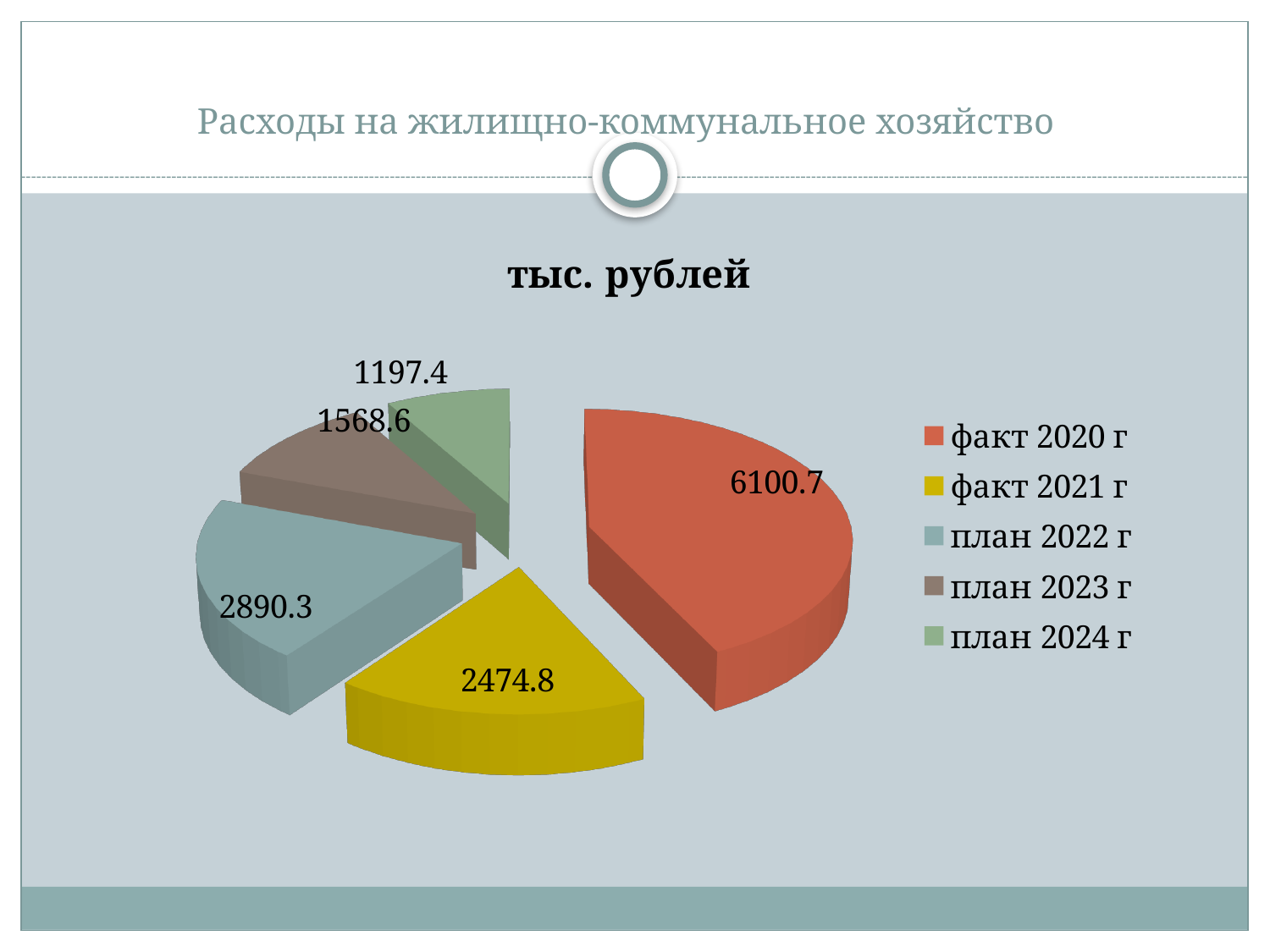
What is the difference between факт 2020 г and факт 2021 г? 3625.9 Which is larger, план 2022 г or факт 2021 г? план 2022 г Which category has the smallest slice? план 2024 г Which category has the largest slice? факт 2020 г How many slices does the pie chart have? 5 What is the value for факт 2020 г? 6100.7 What is the value for план 2022 г? 2890.3 What kind of chart is shown on the slide? pie chart What is the title of the chart? тыс. рублей What is the value for факт 2021 г? 2474.8 What is the difference between план 2023 г and план 2024 г? 371.2 What is the value for план 2024 г? 1197.4